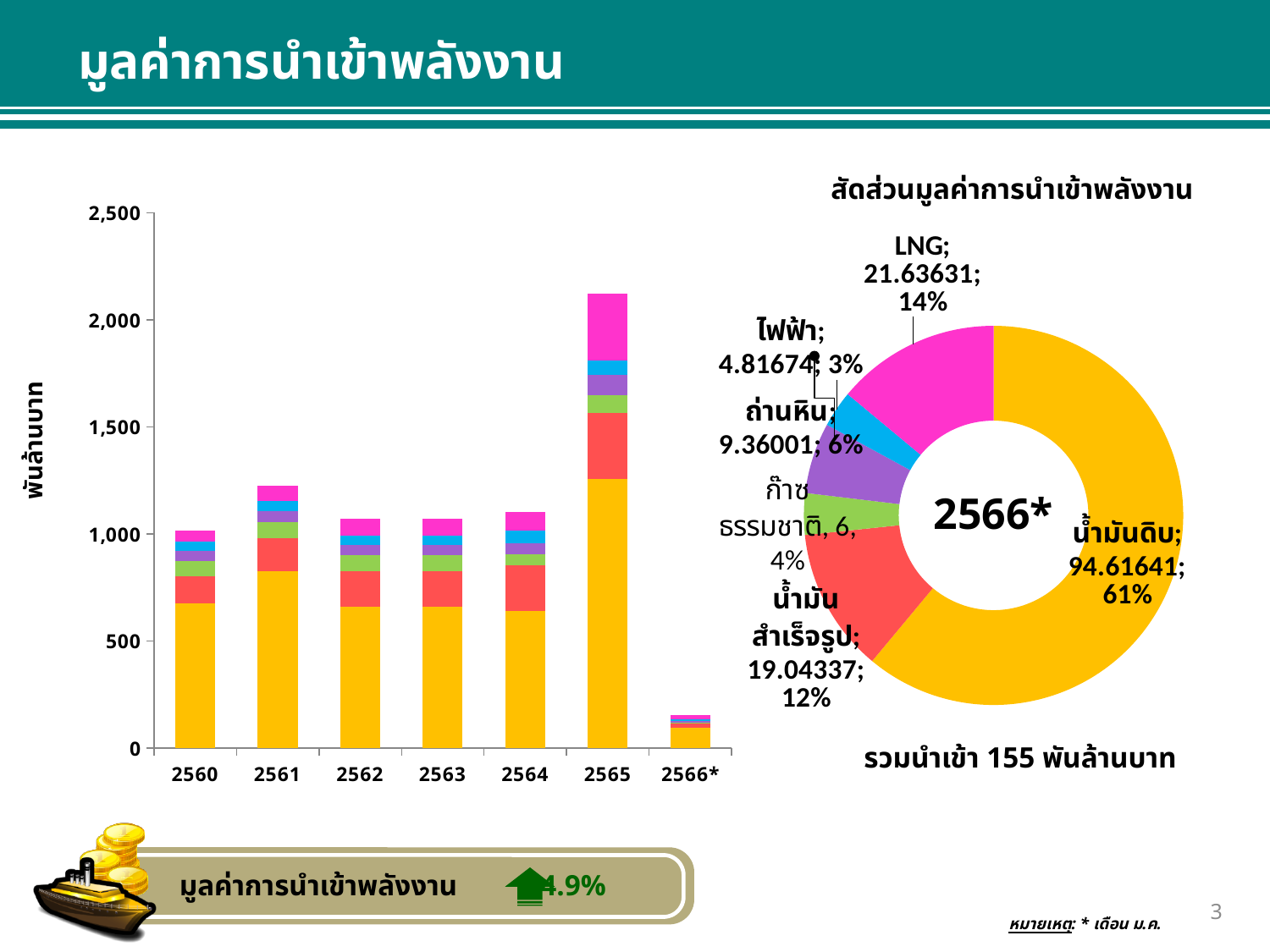
In the bar chart on the left, is the total for 2566* greater or less than 500? less How many years are shown on the x axis of the bar chart on the left? 7 In the bar chart on the left, which year has the shortest stacked bar? 2566* In the bar chart on the left, which year has the tallest stacked bar? 2565 In the bar chart on the left, is the total for 2565 greater or less than 2,000? greater How many categories are shown in the chart titled สัดส่วนมูลค่าการนำเข้าพลังงาน? 6 In the chart titled สัดส่วนมูลค่าการนำเข้าพลังงาน, which category has the smallest share? ไฟฟ้า In the chart titled สัดส่วนมูลค่าการนำเข้าพลังงาน, which is larger, ถ่านหิน or ไฟฟ้า? ถ่านหิน In the chart titled สัดส่วนมูลค่าการนำเข้าพลังงาน, what is the value shown for LNG? 21.63631 In the chart titled สัดส่วนมูลค่าการนำเข้าพลังงาน, what is the difference between the values for LNG and น้ำมันสำเร็จรูป? 2.59294 What kind of chart is the chart on the left of the slide? bar chart In the chart titled สัดส่วนมูลค่าการนำเข้าพลังงาน, what share does น้ำมันดิบ have? 61%